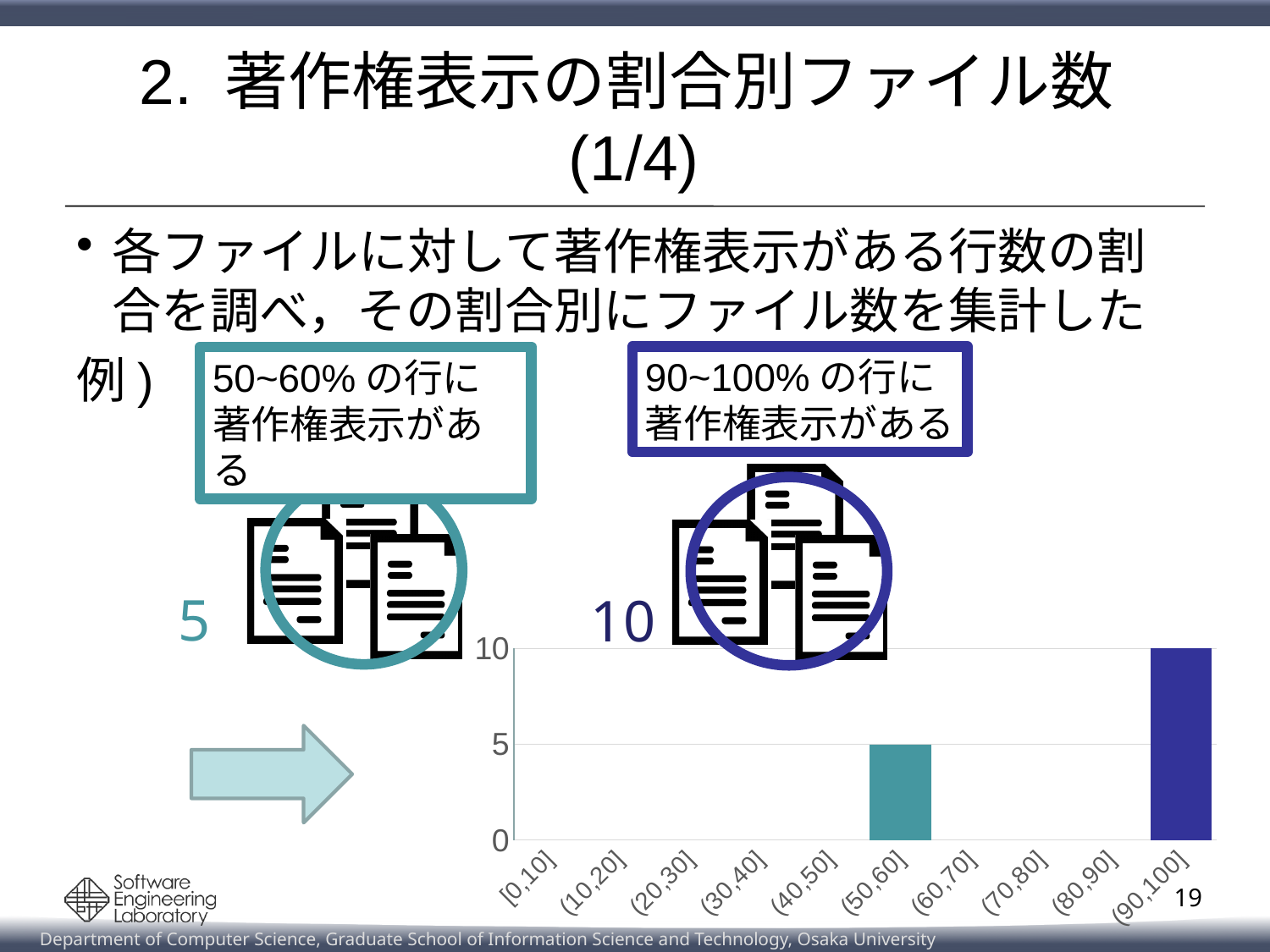
Which category has the highest value in the bar chart? (90,100] Which is larger, the value for (50,60] or the value for (90,100]? (90,100] Is the value for (90,100] greater or less than 5? greater What colour is the bar for the (90,100] category? dark blue What kind of chart is shown on the slide? bar chart What is the highest value shown on the y axis of the chart? 10 How many categories are shown on the x axis of the chart? 10 How many categories in the chart have a visible bar? 2 What is the value for the (90,100] category in the bar chart? 10 What is the value for the (50,60] category in the bar chart? 5 What is the difference between the values for (90,100] and (50,60]? 5